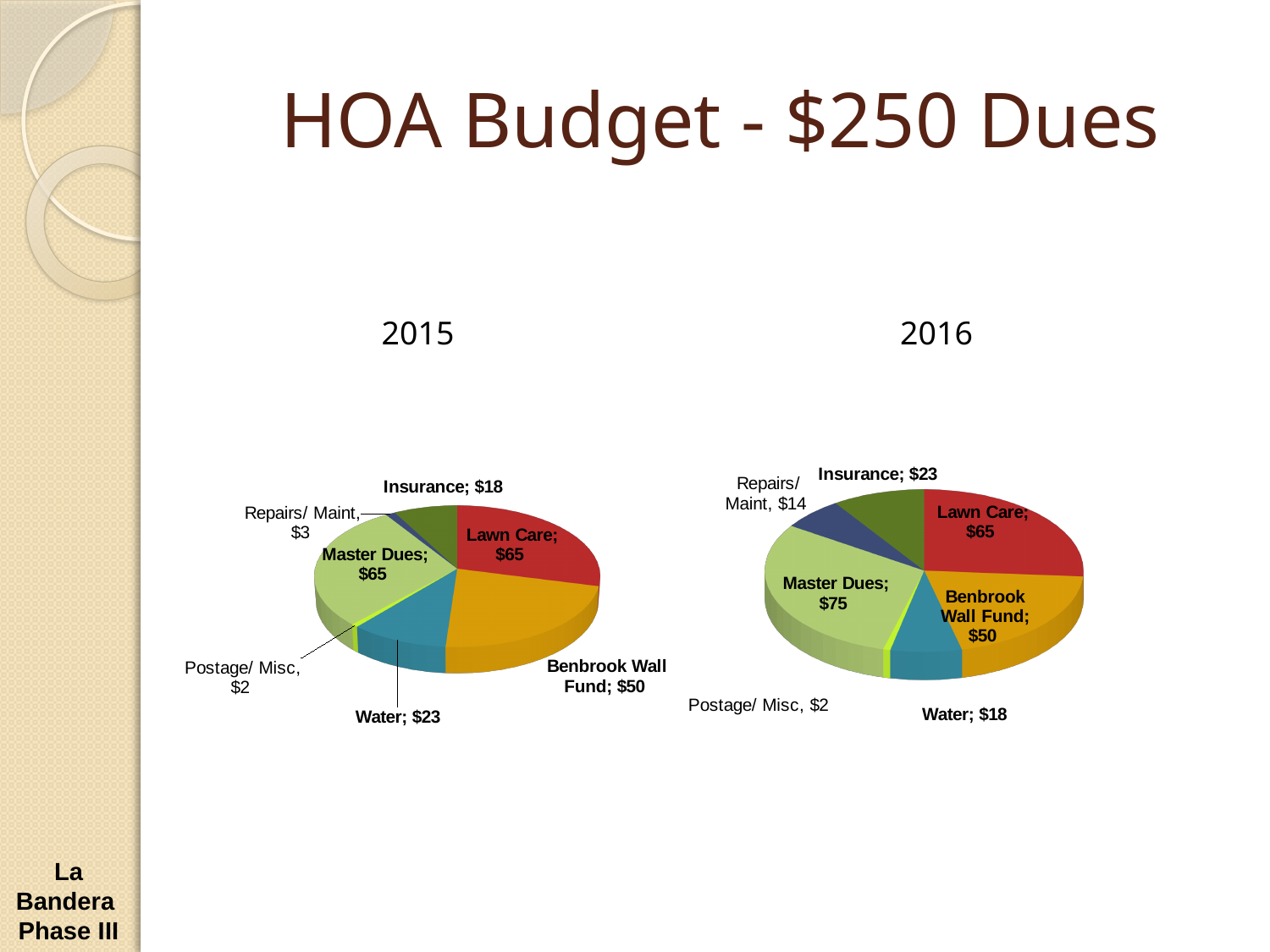
What kind of chart is the 2016 chart? Pie chart What is the difference between Master Dues in the 2016 chart and Master Dues in the 2015 chart? $10 In the 2016 chart, which category has the largest value? Master Dues In the 2015 chart, which category has the smallest value? Postage/ Misc In the 2016 chart, what is the value for Repairs/ Maint? $14 In the 2016 chart, what is the value for Master Dues? $75 How many categories are shown in the 2015 chart? 7 In the 2015 chart, what is the value for Water? $23 In the 2015 chart, what is the value for Benbrook Wall Fund? $50 In the 2016 chart, what is the difference between Lawn Care and Water? $47 What is the title of the slide containing the two charts? HOA Budget - $250 Dues Which is larger: Insurance in the 2015 chart or Insurance in the 2016 chart? 2016